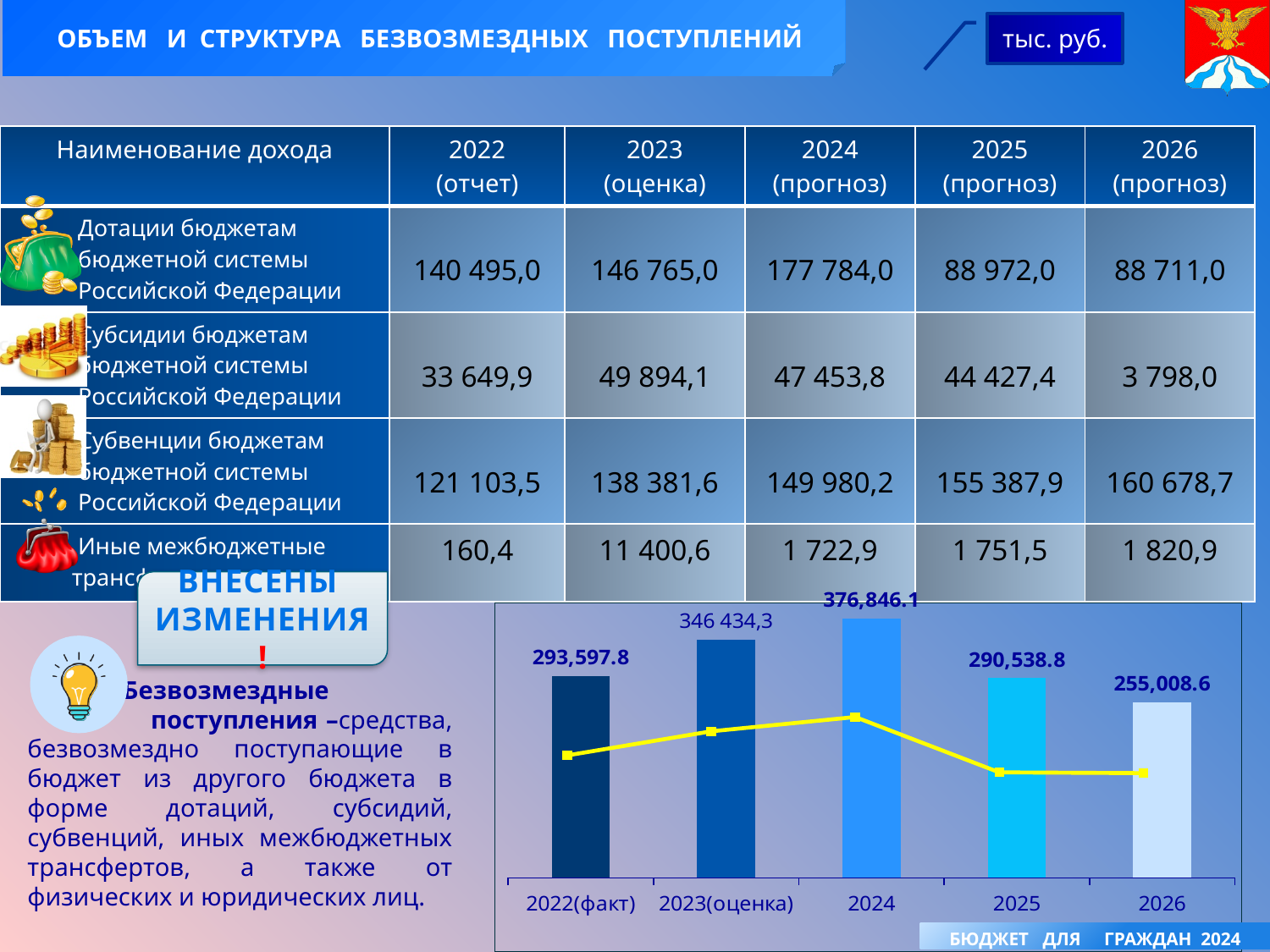
What is the value shown for 2026 in the bar chart? 255,008.6 What is the value shown for 2022(факт) in the bar chart at the bottom of the slide? 293,597.8 How many years (categories) are plotted in the bar chart? 5 What is the value shown for 2023(оценка) in the bar chart? 346 434,3 What is the value shown for 2024 in the bar chart? 376,846.1 Which year has the highest value in the bar chart? 2024 In the bar chart, what is the difference between the 2024 value and the 2022(факт) value? 83,248.3 How do the values in the bar chart change from 2022(факт) to 2026? rise until 2024, then fall In the bar chart, which is larger: the value for 2023(оценка) or the value for 2025? 2023(оценка) What kind of chart is shown at the bottom of the slide? bar chart with a line overlay In the bar chart, what is the difference between the 2025 value and the 2026 value? 35,530.2 Which year has the lowest value in the bar chart? 2026